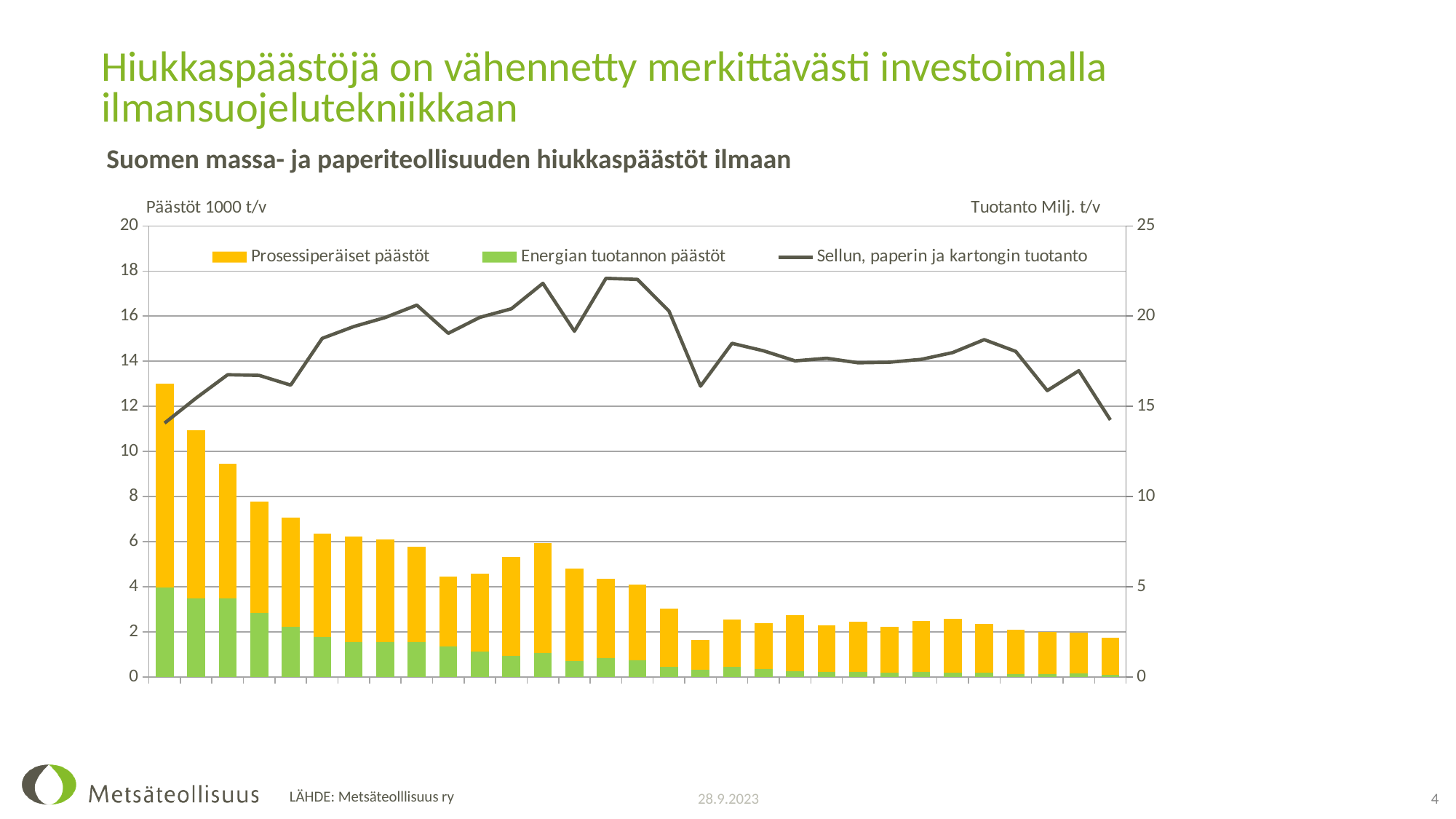
How many series does the legend list? 3 Which is larger, the leftmost stacked bar or the rightmost stacked bar? The leftmost bar Is the highest point of the 'Sellun, paperin ja kartongin tuotanto' line greater or less than 20 on the right axis? greater Is the total height of the leftmost stacked bar greater or less than 12? greater What is the title of the chart? Suomen massa- ja paperiteollisuuden hiukkaspäästöt ilmaan How many stacked bars are plotted in the chart? 31 Do the stacked emission bars generally rise or fall from left to right along the x axis? Fall What kind of chart is shown on the slide? A combined bar and line chart In the leftmost stacked bar, which series contributes the larger part? Prosessiperäiset päästöt Which series is shown in green in the legend? Energian tuotannon päästöt Is the rightmost point of the 'Sellun, paperin ja kartongin tuotanto' line greater or less than 15 on the right axis? less